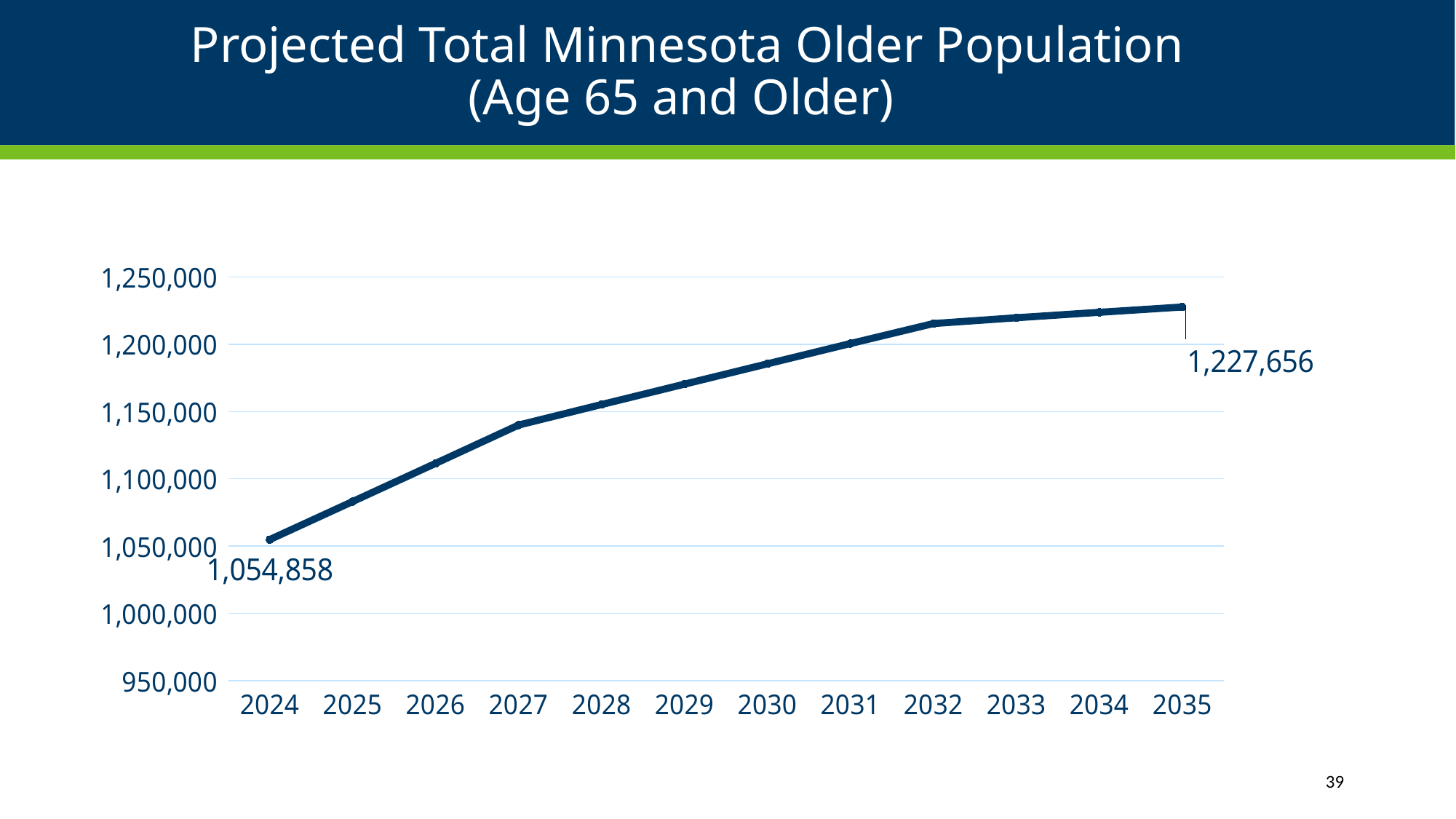
What kind of chart is shown on the slide? Line chart Is the projected older population in 2026 greater or less than 1,150,000? less By how much is the projected older population in 2035 greater than in 2024? 172,798 Which year has the lowest projected older population? 2024 How many years are plotted on the x axis? 12 What is the projected Minnesota older population (age 65 and older) in 2035? 1,227,656 Does the projected older population rise or fall from 2024 to 2035? Rises Which year has the highest projected older population? 2035 Is the projected older population in 2032 greater or less than 1,200,000? greater What is the projected Minnesota older population (age 65 and older) in 2024? 1,054,858 Which year has a larger projected older population, 2027 or 2031? 2031 Is the projected older population in 2030 greater or less than 1,150,000? greater